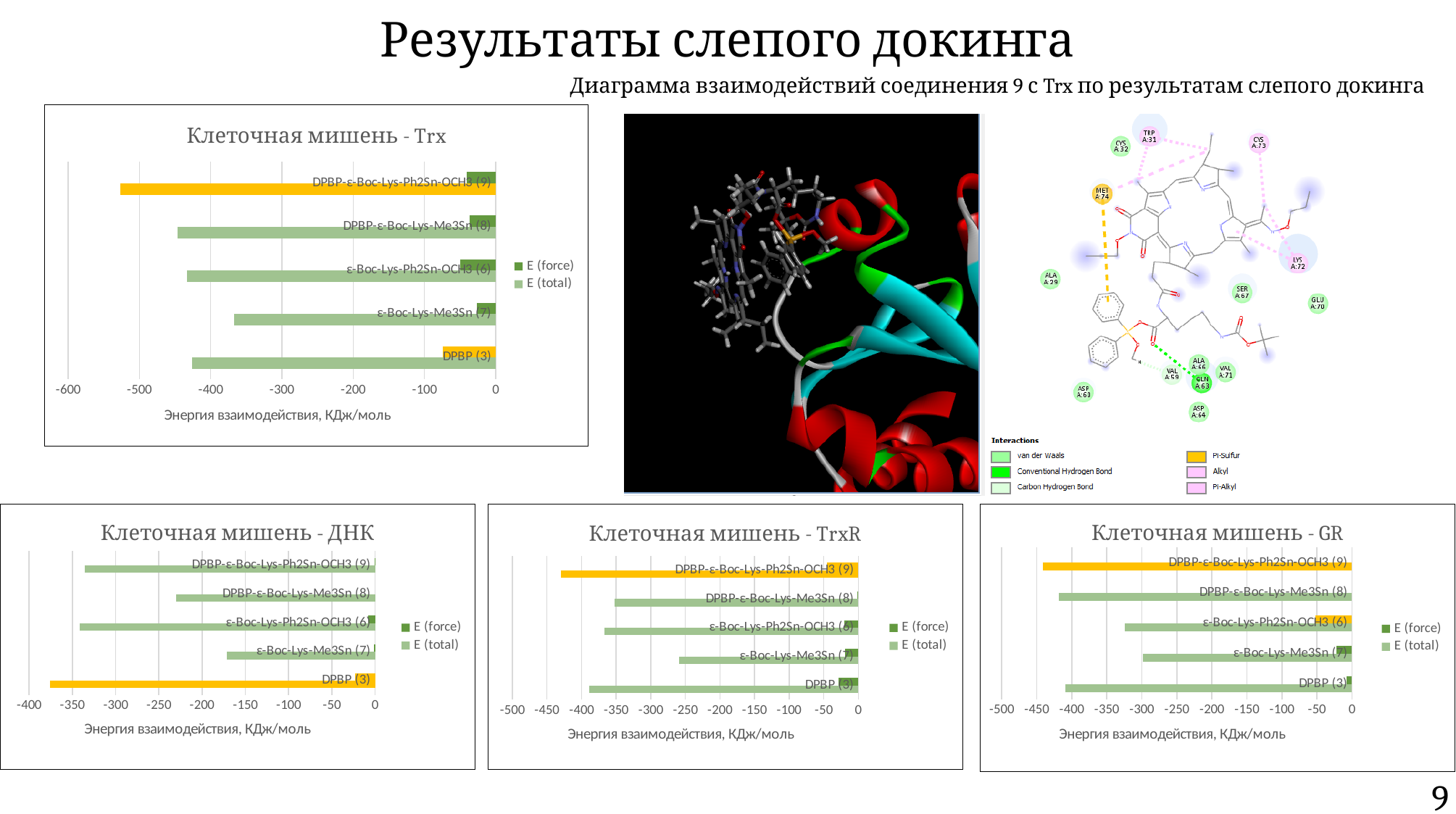
What is the x-axis title of the "Клеточная мишень - GR" chart? Энергия взаимодействия, КДж/моль In the "Клеточная мишень - ДНК" chart, is the E (total) value for ε-Boc-Lys-Me3Sn (7) greater or less than -200? greater In the "Клеточная мишень - GR" chart, is the E (total) value for ε-Boc-Lys-Me3Sn (7) greater or less than -350? greater What kind of chart is "Клеточная мишень - Trx"? Bar chart In the "Клеточная мишень - Trx" chart, is the E (total) value for ε-Boc-Lys-Me3Sn (7) greater or less than -400? greater How many compounds (categories) are plotted in the "Клеточная мишень - ДНК" chart? 5 In the "Клеточная мишень - Trx" chart, which compound has the most negative E (total) value? DPBP-ε-Boc-Lys-Ph2Sn-OCH3 (9) In the "Клеточная мишень - ДНК" chart, which compound has the most negative E (total) value? DPBP (3) In the "Клеточная мишень - TrxR" chart, which compound has the least negative (shortest) E (total) bar? ε-Boc-Lys-Me3Sn (7) How many series does the legend of the "Клеточная мишень - TrxR" chart list? 2